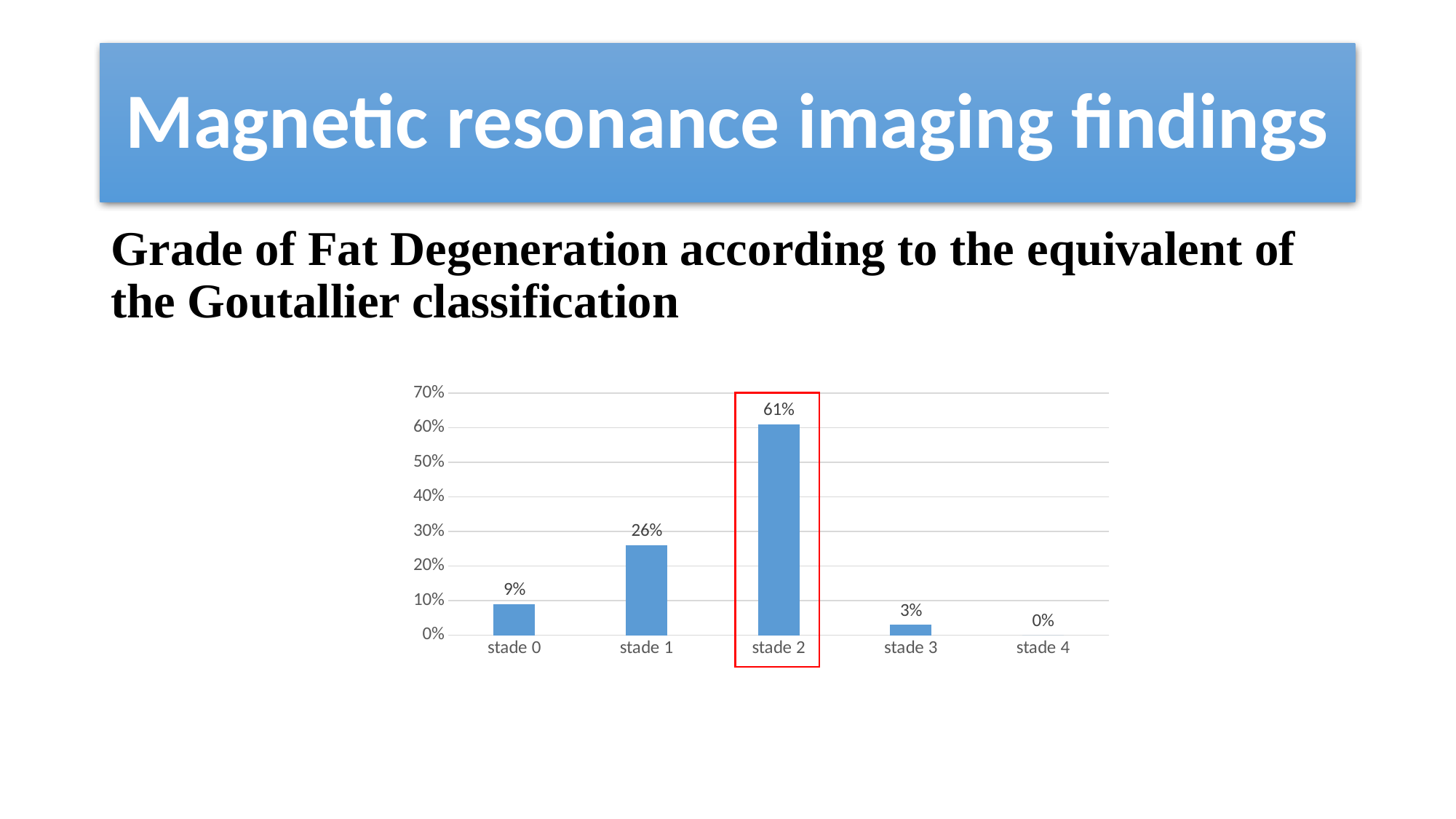
Is the value for stade 2 greater or less than 50%? greater How many categories are shown on the x axis? 5 Which category has the highest value? stade 2 What is the value for stade 4? 0% What kind of chart is shown on the slide? bar chart What is the value for stade 0? 9% Which category has the lowest value? stade 4 What is the value for stade 1? 26% Which is larger, the value for stade 0 or the value for stade 3? stade 0 What is the difference between the values for stade 2 and stade 1? 35% Which bar is outlined with a red box? stade 2 What is the value for stade 2? 61%